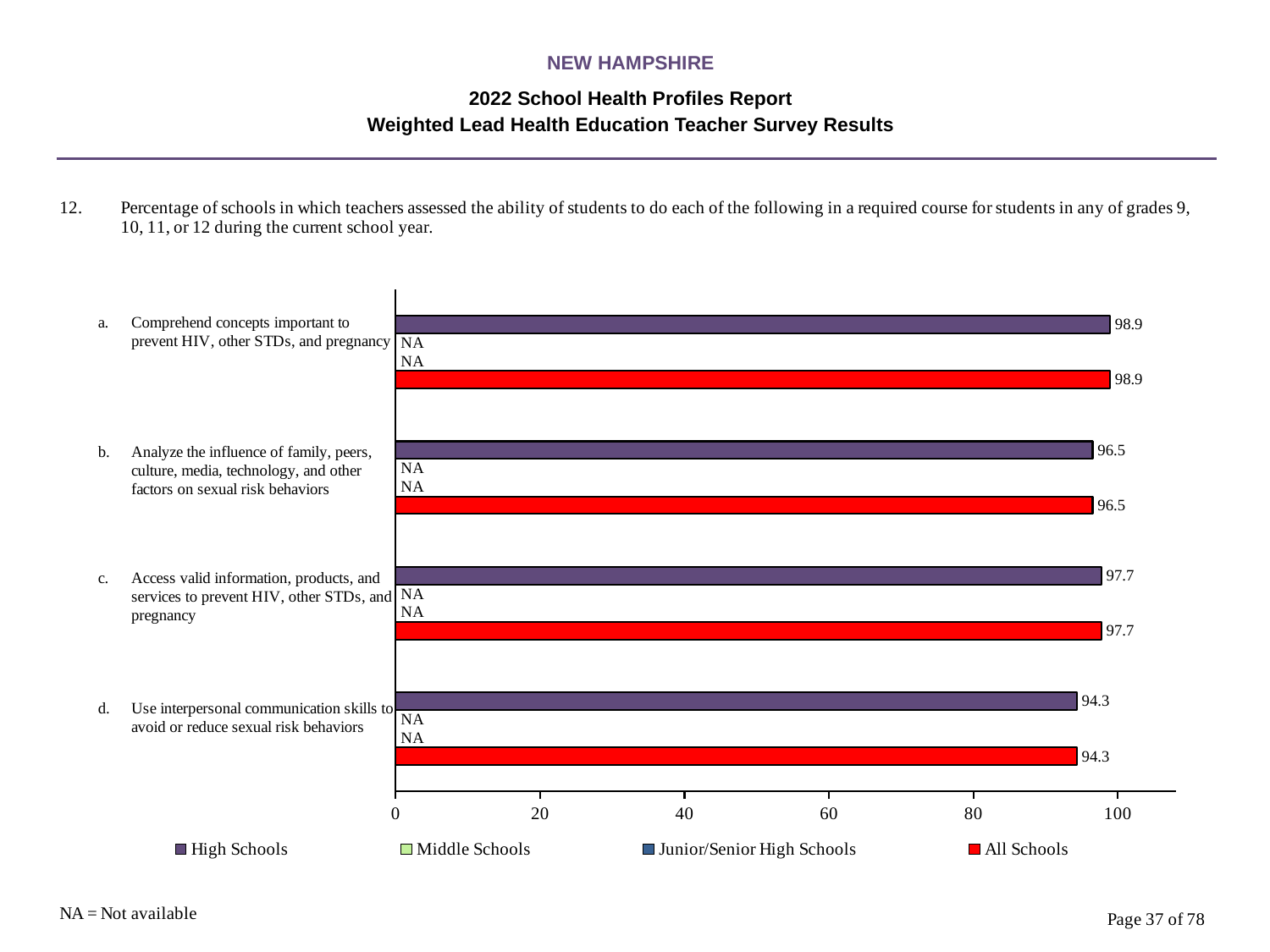
What is the All Schools value for item d, 'Use interpersonal communication skills to avoid or reduce sexual risk behaviors'? 94.3 Is the All Schools value for item d greater or less than 80? greater How many items (categories) are plotted on the chart? 4 What is the High Schools value for item a, 'Comprehend concepts important to prevent HIV, other STDs, and pregnancy'? 98.9 Which item has the highest High Schools value? a. Comprehend concepts important to prevent HIV, other STDs, and pregnancy How many series does the legend list? 4 Which is larger: the High Schools value for item b or for item c? item c (97.7) What kind of chart is shown on the slide? bar chart What value is shown for Middle Schools for item b, 'Analyze the influence of family, peers, culture, media, technology, and other factors on sexual risk behaviors'? NA What is the High Schools value for item c, 'Access valid information, products, and services to prevent HIV, other STDs, and pregnancy'? 97.7 What is the difference between the High Schools values for item a and item d? 4.6 Which item has the lowest All Schools value? d. Use interpersonal communication skills to avoid or reduce sexual risk behaviors